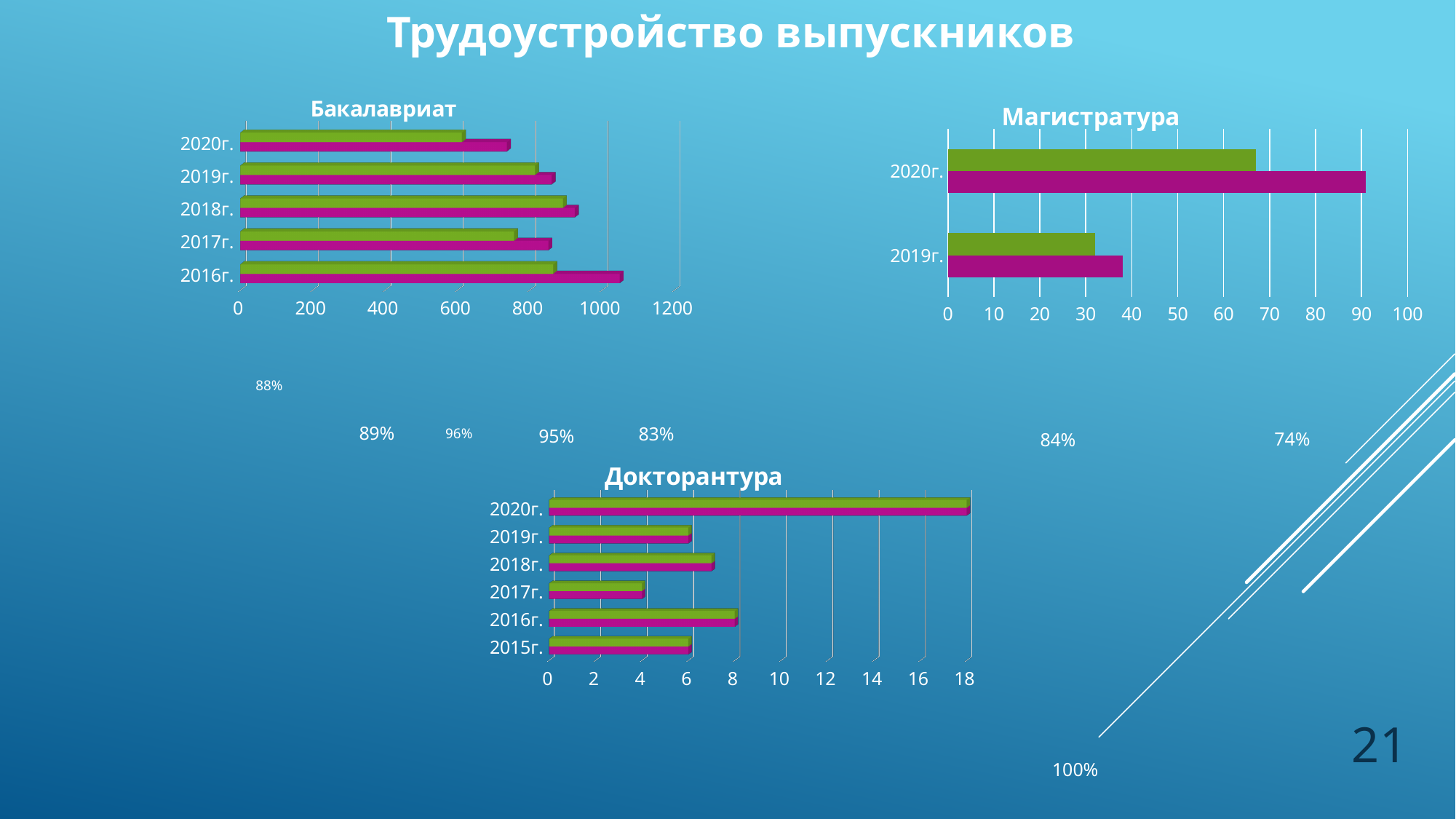
In the Докторантура chart, is the green bar for 2017г. greater or less than 6? less What kind of chart is the Бакалавриат chart? bar chart In the Магистратура chart, is the magenta bar for 2020г. greater or less than 80? greater In the Бакалавриат chart, is the green bar for 2020г. greater or less than 800? less In the Бакалавриат chart, which year has the longest magenta bar? 2016г. How many year categories does the Докторантура chart show? 6 In the Магистратура chart, which year has the larger green bar, 2019г. or 2020г.? 2020г. How many year categories does the Магистратура chart show? 2 How many year categories does the Бакалавриат chart show? 5 In the Докторантура chart, which year has the longest bars? 2020г.